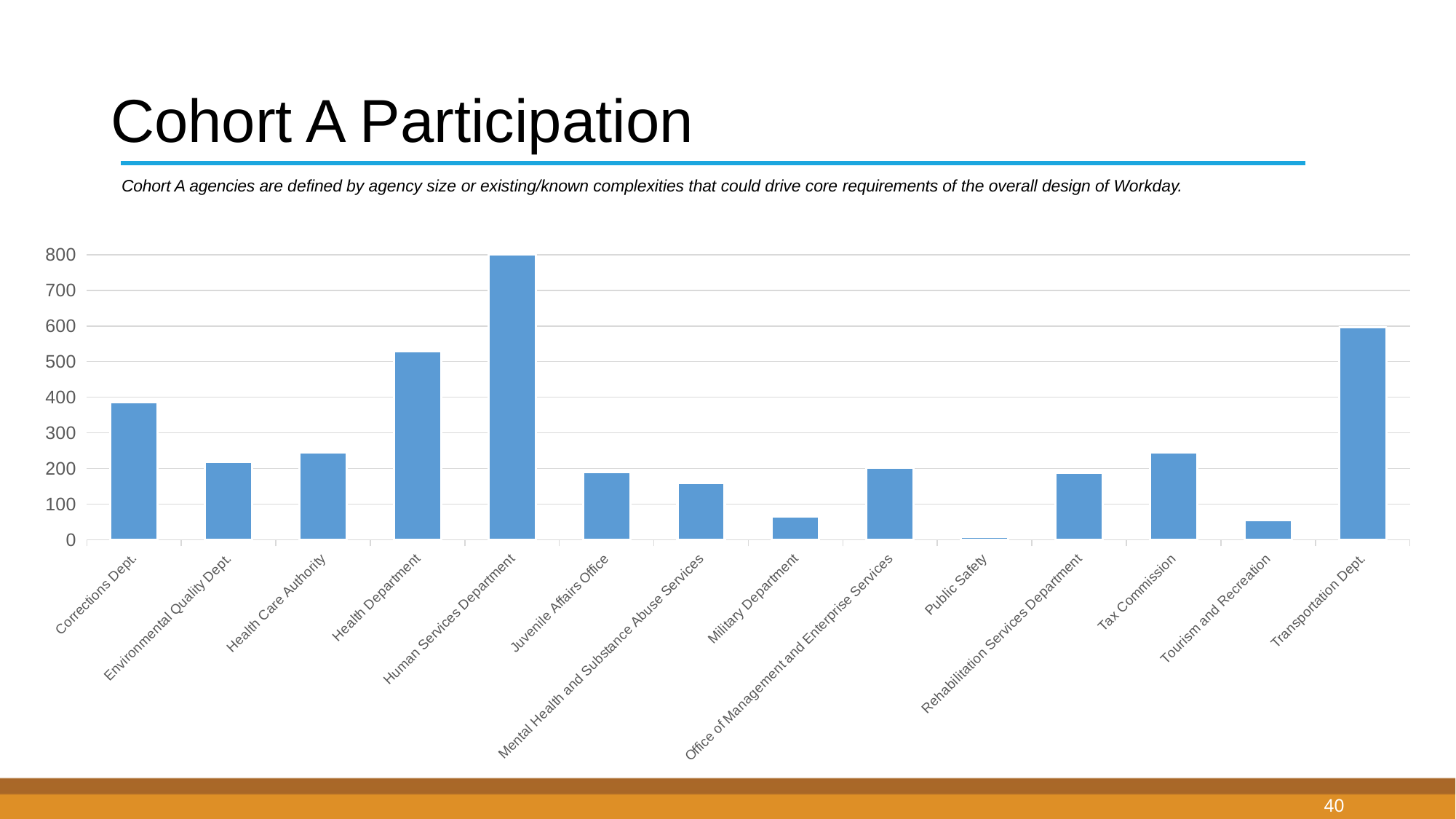
Is the value for Health Department greater or less than 500? greater What is the title of the slide containing the chart? Cohort A Participation Is the value for Corrections Dept. greater or less than 300? greater Which agency has the highest bar in the chart? Human Services Department How many agencies are shown on the x axis of the chart? 14 Which is larger, the value for Human Services Department or the value for Transportation Dept.? Human Services Department Is the value for Military Department greater or less than 100? less Which agency has the lowest bar in the chart? Public Safety Which is larger, the value for Corrections Dept. or the value for Health Care Authority? Corrections Dept. What kind of chart is shown on the slide? bar chart